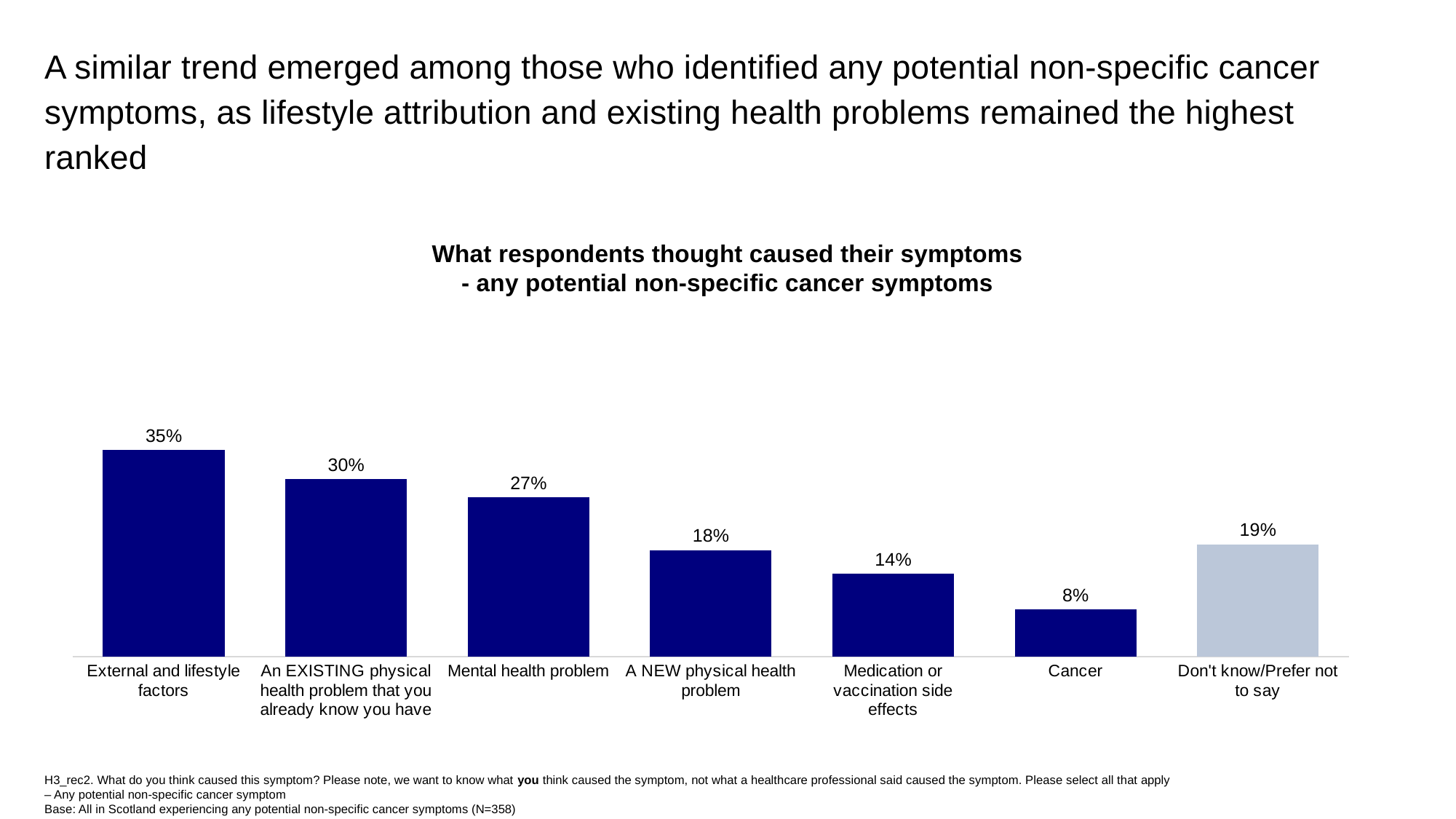
What is the value for 'Don't know/Prefer not to say'? 19% Which is larger: the value for 'A NEW physical health problem' or 'Don't know/Prefer not to say'? Don't know/Prefer not to say Which category has the highest value? External and lifestyle factors What type of chart is shown on the slide? Bar chart What is the title of the chart? What respondents thought caused their symptoms - any potential non-specific cancer symptoms What percentage of respondents thought cancer caused their symptoms? 8% Which category has the lowest value? Cancer What is the value for 'Medication or vaccination side effects'? 14% Which bar is shown in a lighter colour than the others? Don't know/Prefer not to say What percentage of respondents attributed their symptoms to external and lifestyle factors? 35% How many categories are shown in the chart? 7 What is the difference between the values for 'External and lifestyle factors' and 'Mental health problem'? 8 percentage points